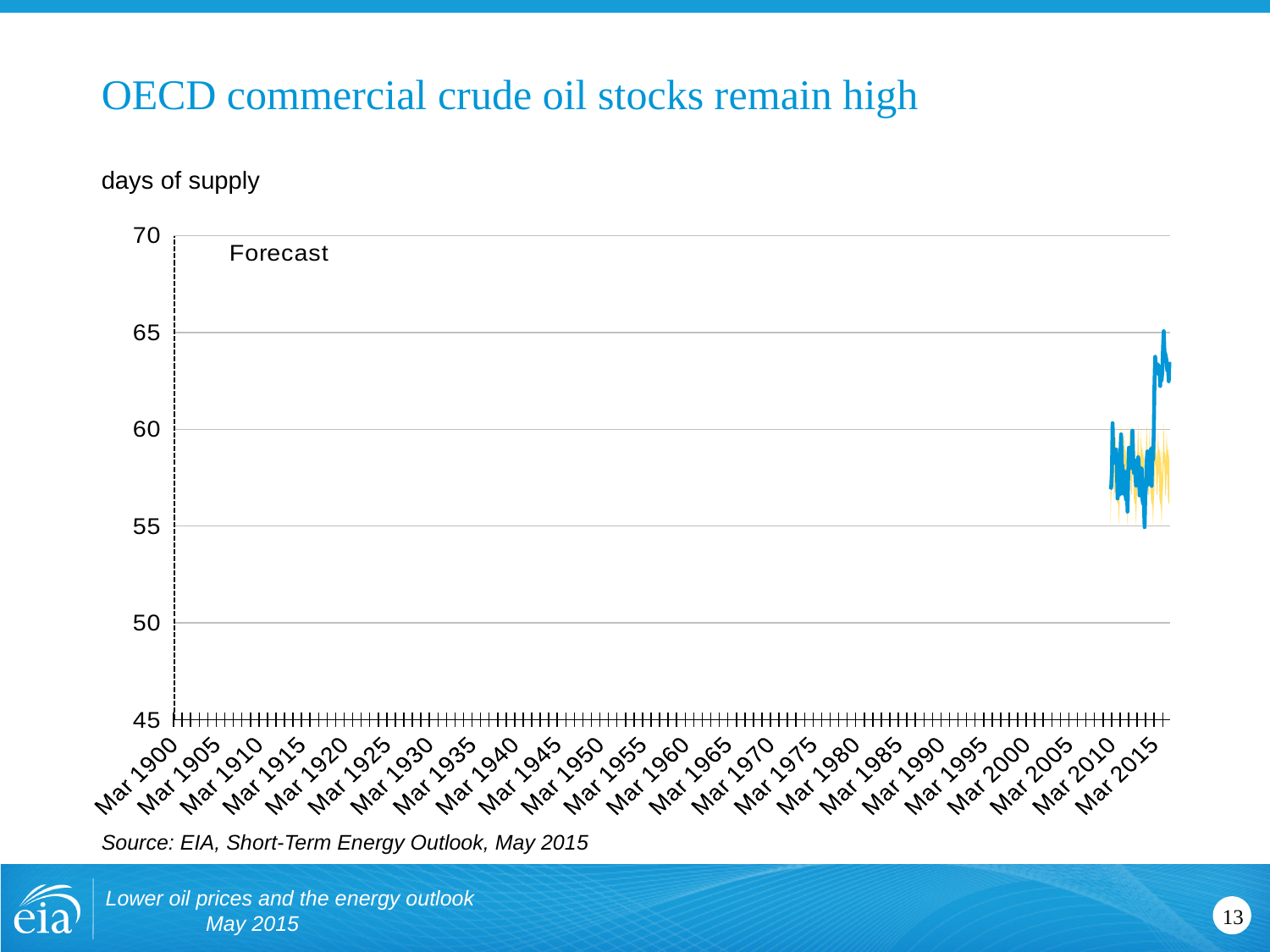
What is the title of the chart on the slide? OECD commercial crude oil stocks remain high What kind of chart is shown on the slide? line chart Is the lowest value reached by the blue line greater or less than 60? less Are the yellow forecast values greater or less than 50? greater What unit is the y axis of the chart measured in? days of supply Does the blue line rise or fall in its final stretch approaching Mar 2015? rise Is the lowest value reached by the blue line greater or less than 50? greater